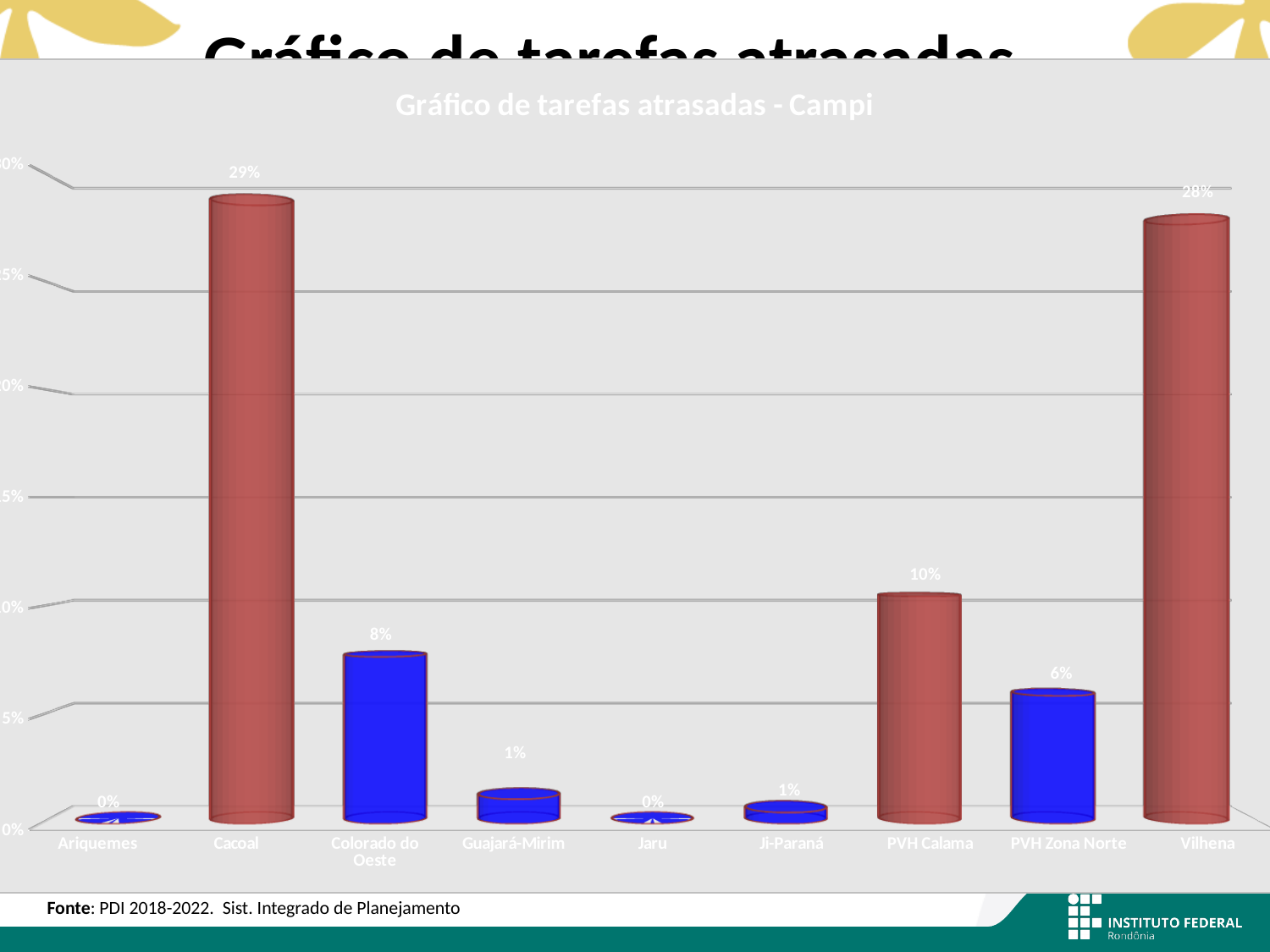
Which is larger, the value for Colorado do Oeste or the value for PVH Zona Norte? Colorado do Oeste What is the value for Cacoal? 29% What kind of chart is shown? Bar chart Which campus has the highest value? Cacoal What is the title of the chart? Gráfico de tarefas atrasadas - Campi How many campi are shown on the x axis? 9 What is the value for Colorado do Oeste? 8% What is the value for Vilhena? 28% What is the value for PVH Zona Norte? 6% What is the difference between the values for PVH Calama and PVH Zona Norte? 4% What is the difference between the values for Cacoal and Vilhena? 1% What is the value for PVH Calama? 10%